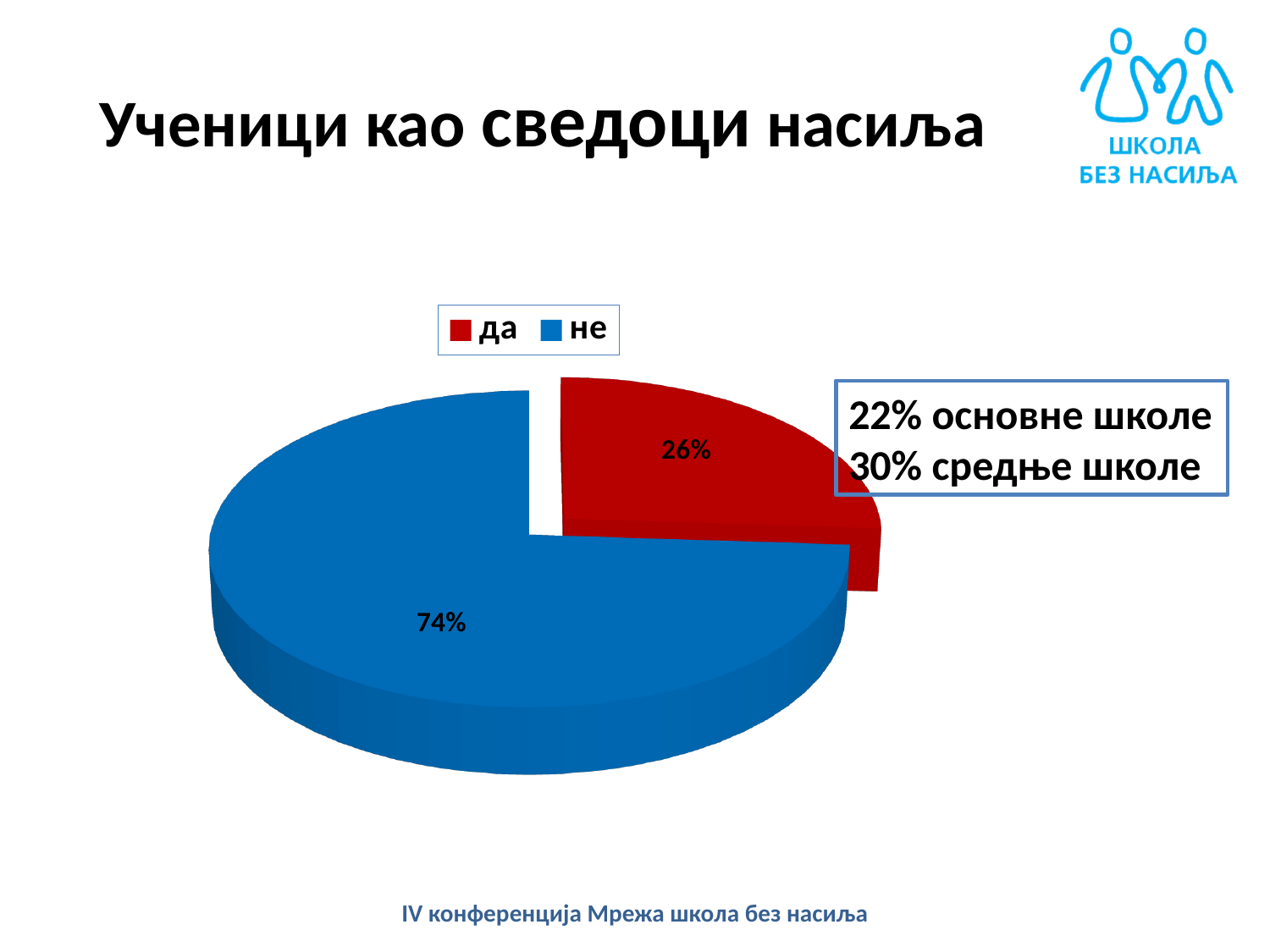
What colour is the "да" slice? red What colour is the "не" slice? blue What type of chart is shown on the slide? pie chart What is the difference in percentage points between the "не" and "да" slices? 48 How many entries does the legend list? 2 What share of the pie does the "да" slice represent? 26% Which slice is the smallest? да How many slices does the pie chart have? 2 What percentage does the "да" slice show? 26% What percentage does the "не" slice show? 74% Which slice is the largest? не Which is larger, the "да" slice or the "не" slice? не